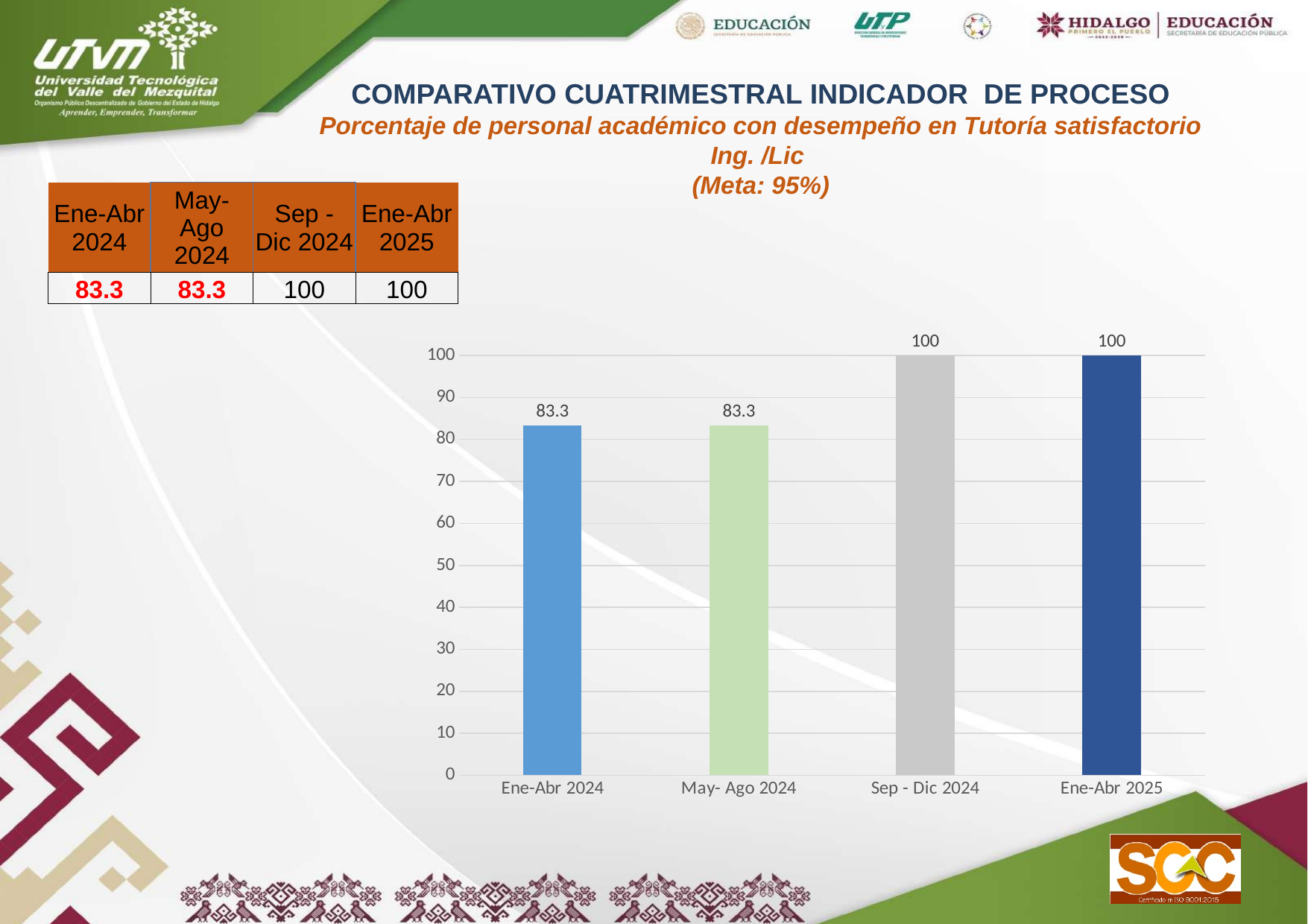
Is the value for Ene-Abr 2024 greater or less than 90? less What is the target (Meta) stated in the chart title? 95% What is the value for Ene-Abr 2025? 100 Which category has the lowest value, Ene-Abr 2024 or Sep - Dic 2024? Ene-Abr 2024 What is the value for Ene-Abr 2024? 83.3 What colour is the bar for Sep - Dic 2024? grey What kind of chart is shown on the slide? bar chart How many categories are shown on the x axis? 4 What is the difference between the values for Sep - Dic 2024 and May- Ago 2024? 16.7 What is the value for Sep - Dic 2024? 100 Do the values rise or fall from Ene-Abr 2024 to Ene-Abr 2025? rise What is the value for May- Ago 2024? 83.3